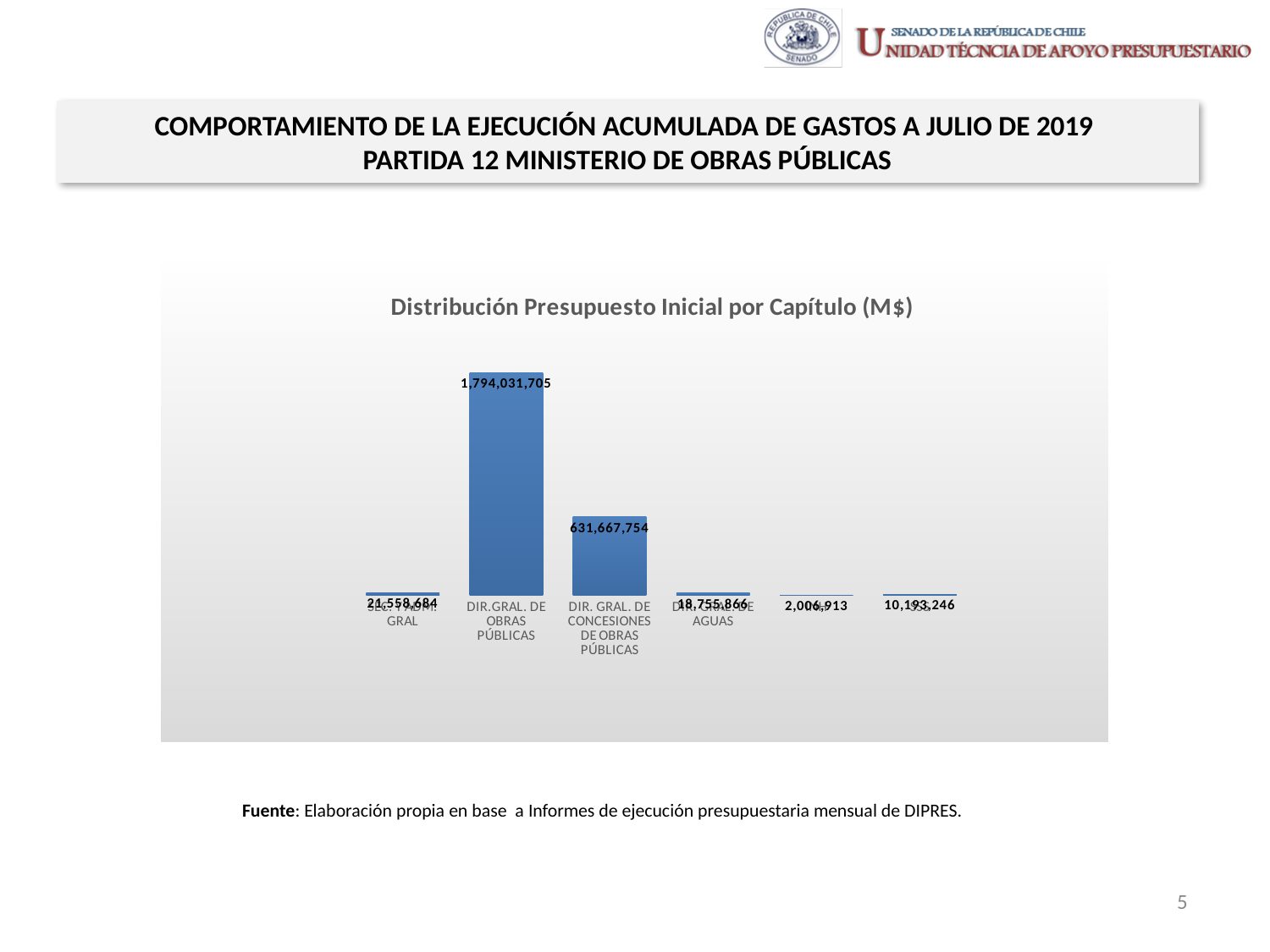
What is the value for DIR.GRAL. DE OBRAS PÚBLICAS in the chart? 1,794,031,705 What kind of chart is shown on the slide? Bar chart What is the title of the chart? Distribución Presupuesto Inicial por Capítulo (M$) How many bars are plotted in the chart? 6 What is the smallest value shown in the chart? 2,006,913 Which category has the highest value in the chart? DIR.GRAL. DE OBRAS PÚBLICAS What is the difference between the values for DIR. GRAL. DE CONCESIONES DE OBRAS PÚBLICAS and DIR. GRAL. DE AGUAS? 612,911,888 In what unit are the values in the chart expressed, according to its title? M$ What is the value for DIR. GRAL. DE CONCESIONES DE OBRAS PÚBLICAS? 631,667,754 What is the value for DIR. GRAL. DE AGUAS? 18,755,866 What is the difference between the values for DIR.GRAL. DE OBRAS PÚBLICAS and DIR. GRAL. DE CONCESIONES DE OBRAS PÚBLICAS? 1,162,363,951 Which is larger, the value for DIR. GRAL. DE CONCESIONES DE OBRAS PÚBLICAS or the value for DIR. GRAL. DE AGUAS? DIR. GRAL. DE CONCESIONES DE OBRAS PÚBLICAS